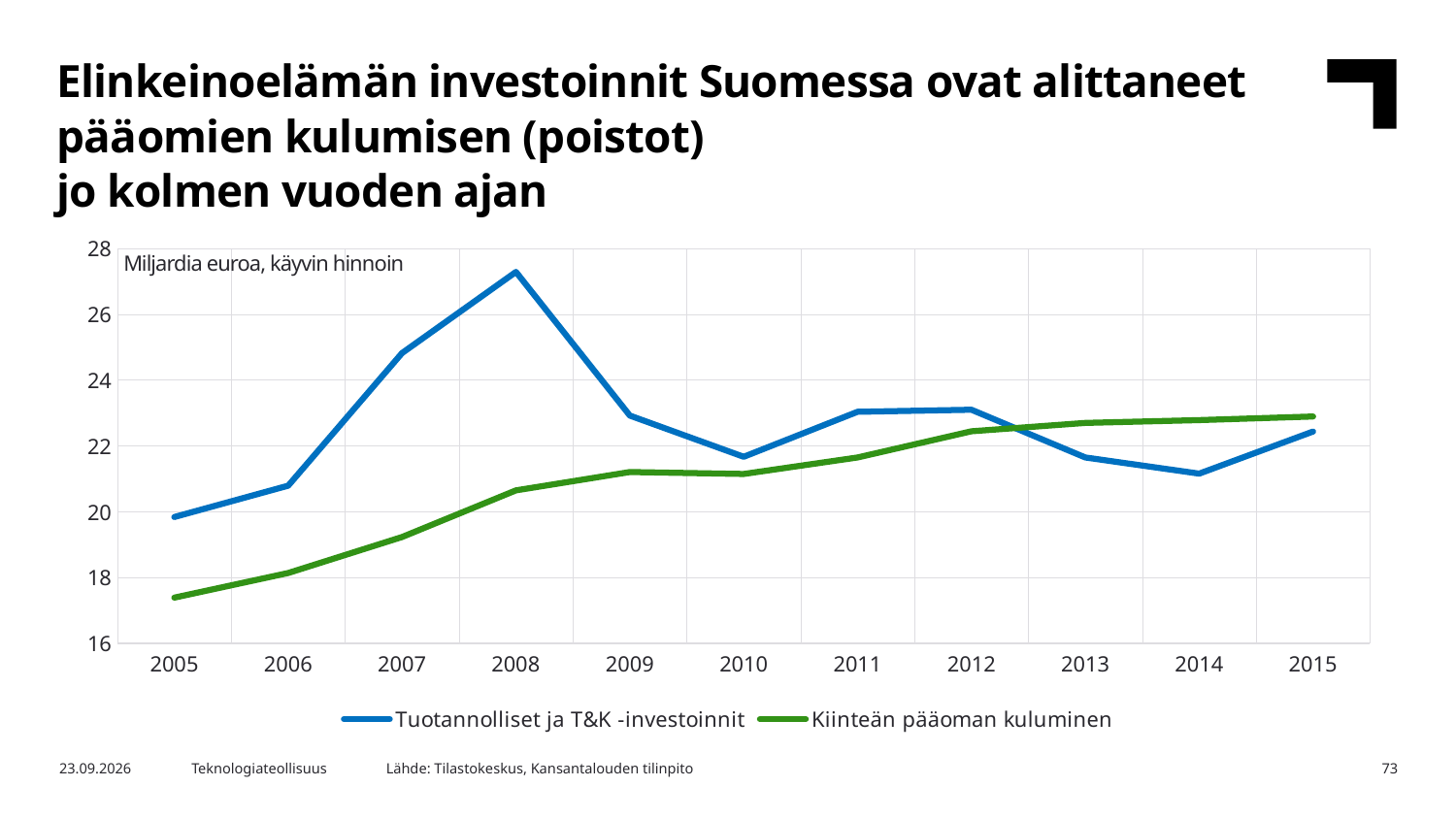
How many years are shown on the x axis? 11 Is the value for Tuotannolliset ja T&K -investoinnit in 2008 greater or less than 26? greater What kind of chart is shown on the slide? line chart How many series does the legend list? 2 In 2014, which series has the higher value: Tuotannolliset ja T&K -investoinnit or Kiinteän pääoman kuluminen? Kiinteän pääoman kuluminen In which year is the Tuotannolliset ja T&K -investoinnit series at its lowest? 2005 Does the Kiinteän pääoman kuluminen series generally rise or fall from 2005 to 2015? rise In which year is the Kiinteän pääoman kuluminen series at its lowest? 2005 What unit is stated in the label at the top left of the chart area? Miljardia euroa, käyvin hinnoin Is the value for Kiinteän pääoman kuluminen in 2005 greater or less than 18? less Is the value for Tuotannolliset ja T&K -investoinnit in 2014 greater or less than 22? less In which year does the Tuotannolliset ja T&K -investoinnit series reach its highest value? 2008